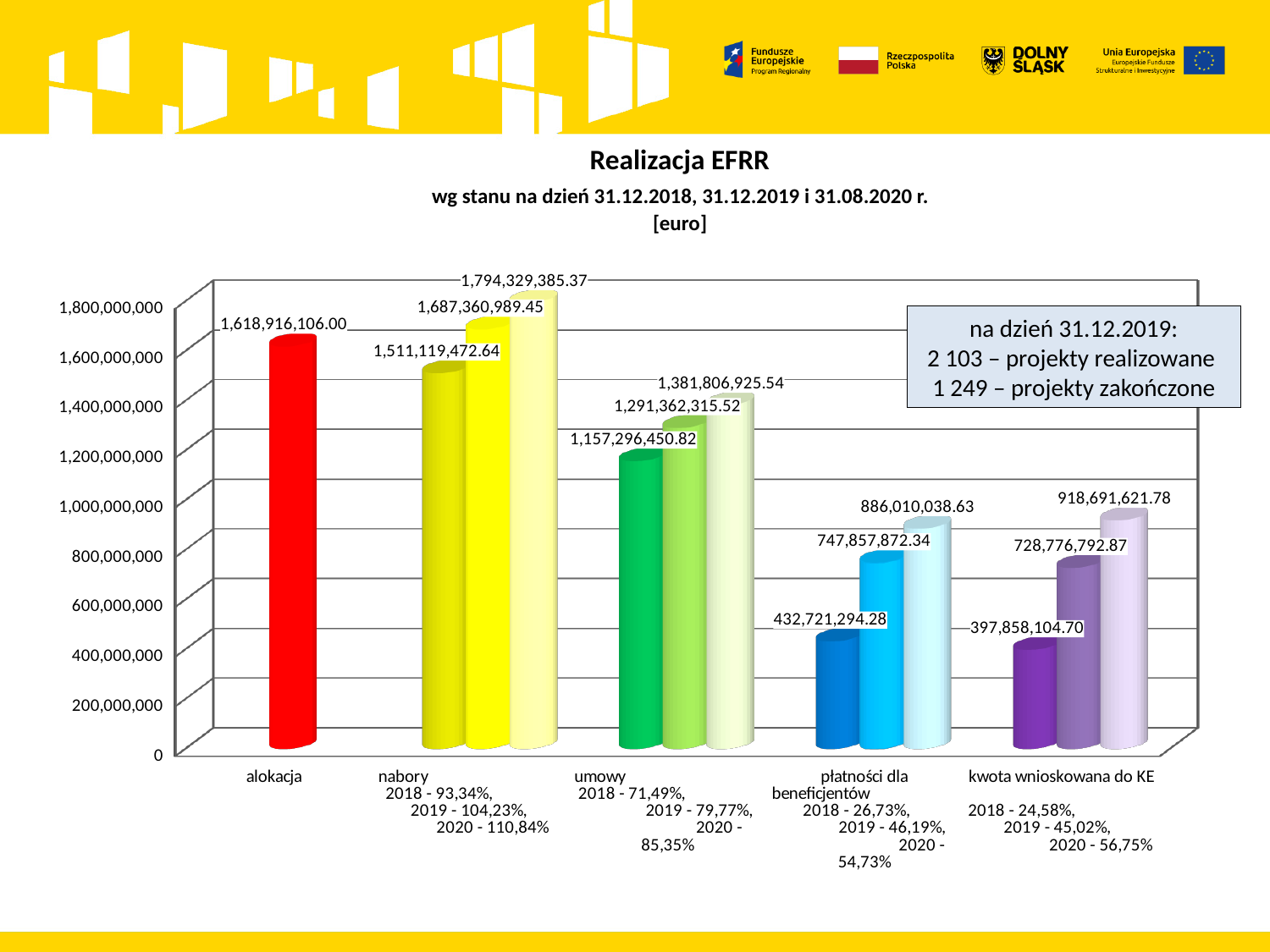
What is the value of the tallest bar in the nabory group (2020)? 1,794,329,385.37 What is the value of the first (2018) bar in the płatności dla beneficjentów group? 432,721,294.28 How many categories are shown on the x axis? 5 What kind of chart is shown on the slide? bar chart Which is larger: the 2020 bar for płatności dla beneficjentów or the 2020 bar for kwota wnioskowana do KE? kwota wnioskowana do KE 2020 What is the difference between the 2020 and 2018 bars in the płatności dla beneficjentów group? 453,288,744.35 Is the value of the 2018 bar in the umowy group greater or less than 1,200,000,000? less Which bar on the chart has the lowest value? kwota wnioskowana do KE 2018 (397,858,104.70) What is the value of the middle (2019) bar in the umowy group? 1,291,362,315.52 What is the difference between the 2020 and 2018 bars in the nabory group? 283,209,912.73 What is the value of the alokacja bar? 1,618,916,106.00 Which bar on the chart has the highest value? nabory 2020 (1,794,329,385.37)